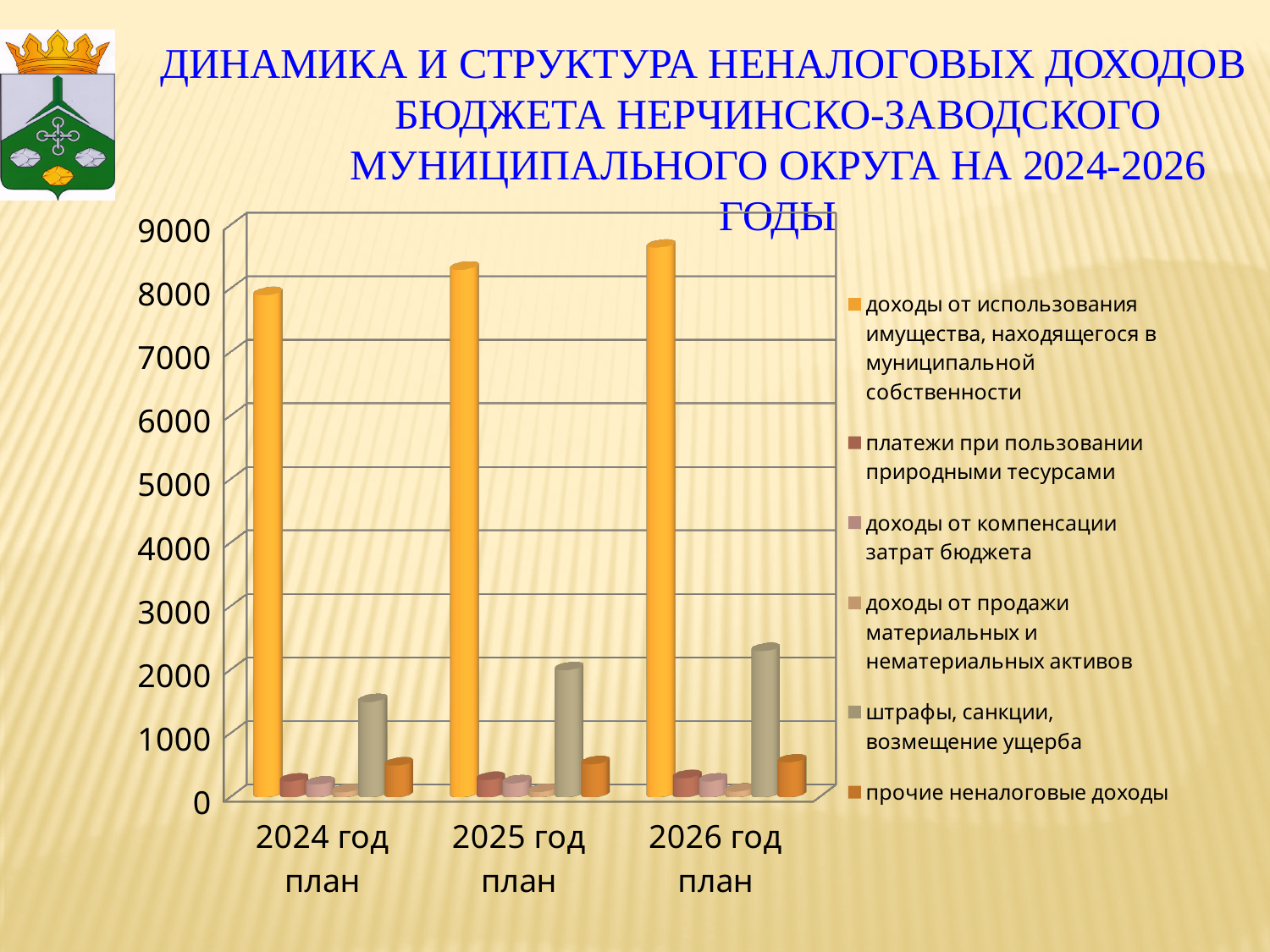
Is the value for штрафы, санкции, возмещение ущерба in 2026 год план greater or less than 2000? greater Is the value for доходы от использования имущества, находящегося в муниципальной собственности in 2026 год план greater or less than 9000? less Do the values for доходы от использования имущества, находящегося в муниципальной собственности rise or fall from 2024 год план to 2026 год план? rise Which is larger: штрафы, санкции, возмещение ущерба in 2024 год план or in 2026 год план? 2026 год план Which series has the tallest bar in every year? доходы от использования имущества, находящегося в муниципальной собственности What kind of chart is shown on the slide? bar chart In which year is the bar for доходы от использования имущества, находящегося в муниципальной собственности the highest? 2026 год план How many series does the legend list? 6 Is the value for доходы от использования имущества, находящегося в муниципальной собственности in 2024 год план greater or less than 7000? greater Which series is shown in grey in the legend? штрафы, санкции, возмещение ущерба How many year categories are shown on the x axis? 3